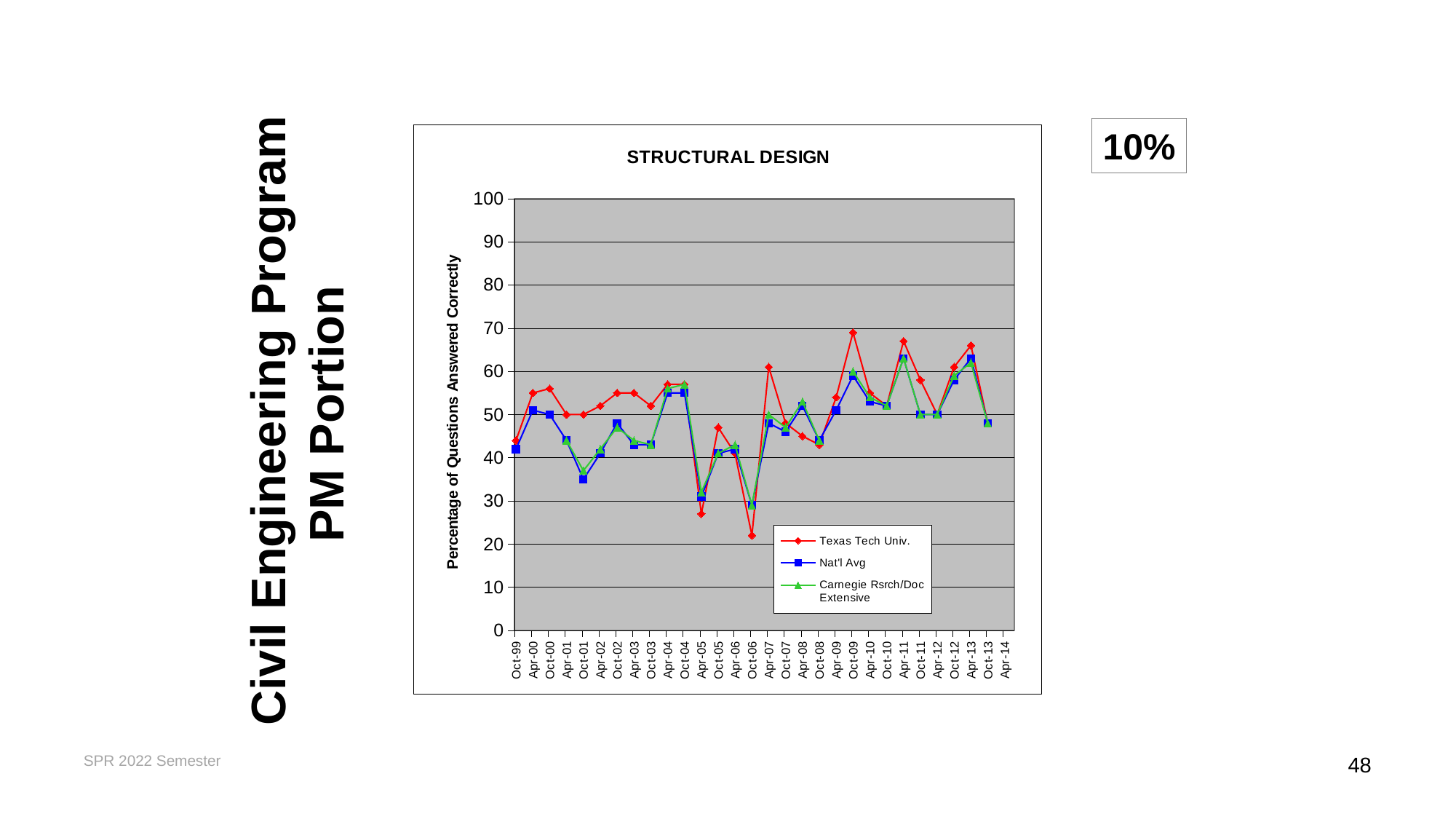
Is the Texas Tech Univ. value for Oct-06 greater or less than 30? less Is the Nat'l Avg value for Apr-13 greater or less than 60? greater What kind of chart is shown on the slide? line chart What is the title of the chart? STRUCTURAL DESIGN Is the Nat'l Avg value for Oct-01 greater or less than 40? less What is the label on the vertical axis of the chart? Percentage of Questions Answered Correctly How many series does the legend list? 3 At Oct-06, which is higher: Texas Tech Univ. or Nat'l Avg? Nat'l Avg At which date does the Texas Tech Univ. series reach its highest value? Oct-09 Does the Texas Tech Univ. series rise or fall from Apr-06 to Oct-06? fall At which date does the Texas Tech Univ. series reach its lowest value? Oct-06